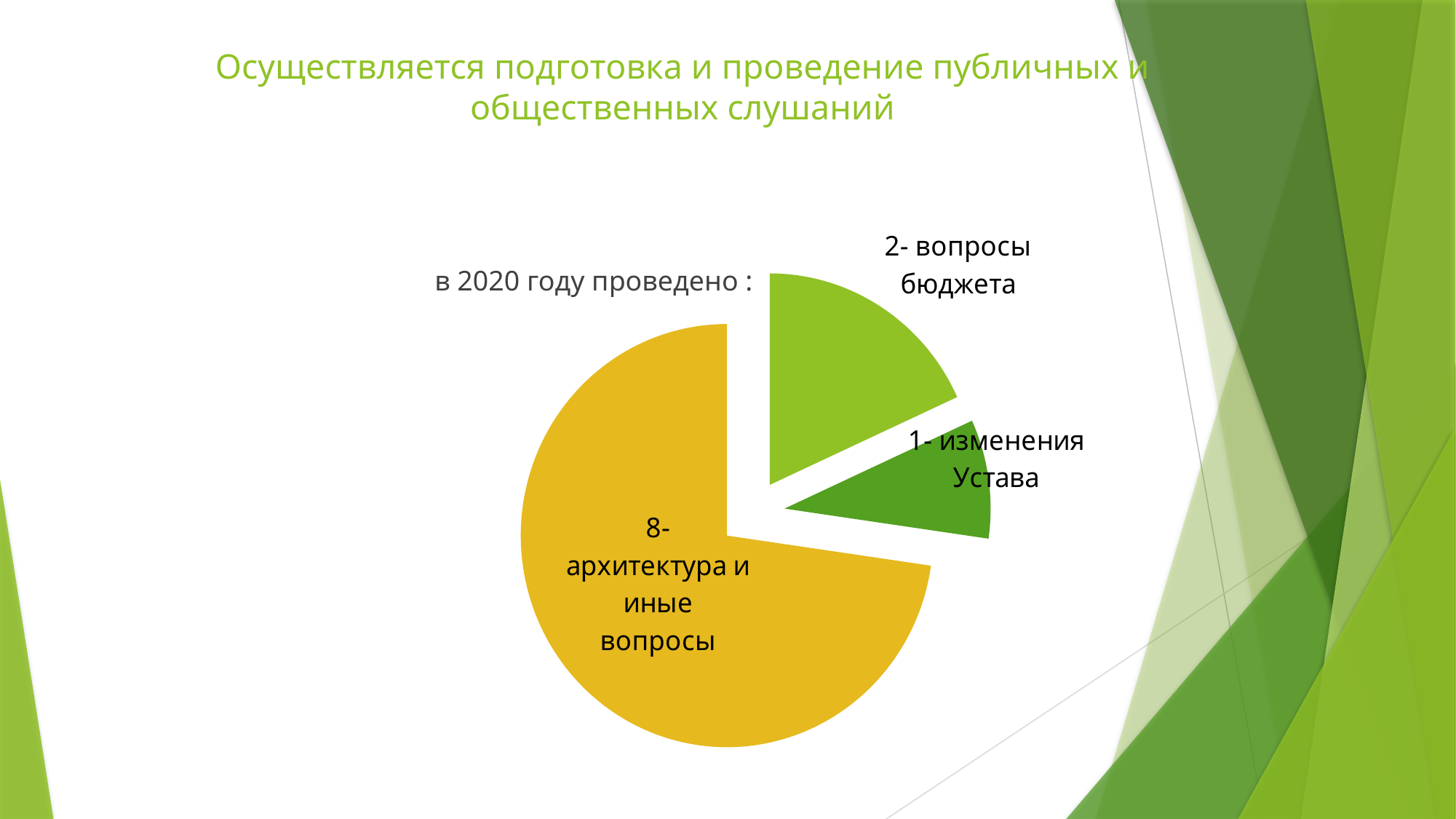
How many hearings were held on вопросы бюджета according to the pie chart? 2 What is the total number of hearings shown in the pie chart? 11 What is the title of the pie chart? в 2020 году проведено : How many hearings were held on архитектура и иные вопросы according to the pie chart? 8 How many slices does the pie chart have? 3 What share of all hearings in the pie chart does архитектура и иные вопросы account for? 8 of 11 What kind of chart is shown on the slide? pie chart Which category has the smallest slice in the pie chart? изменения Устава How many hearings were held on изменения Устава according to the pie chart? 1 Which is larger: the number of hearings on вопросы бюджета or on изменения Устава? вопросы бюджета Which category has the largest slice in the pie chart? архитектура и иные вопросы What is the difference between the number of hearings on архитектура и иные вопросы and on вопросы бюджета? 6